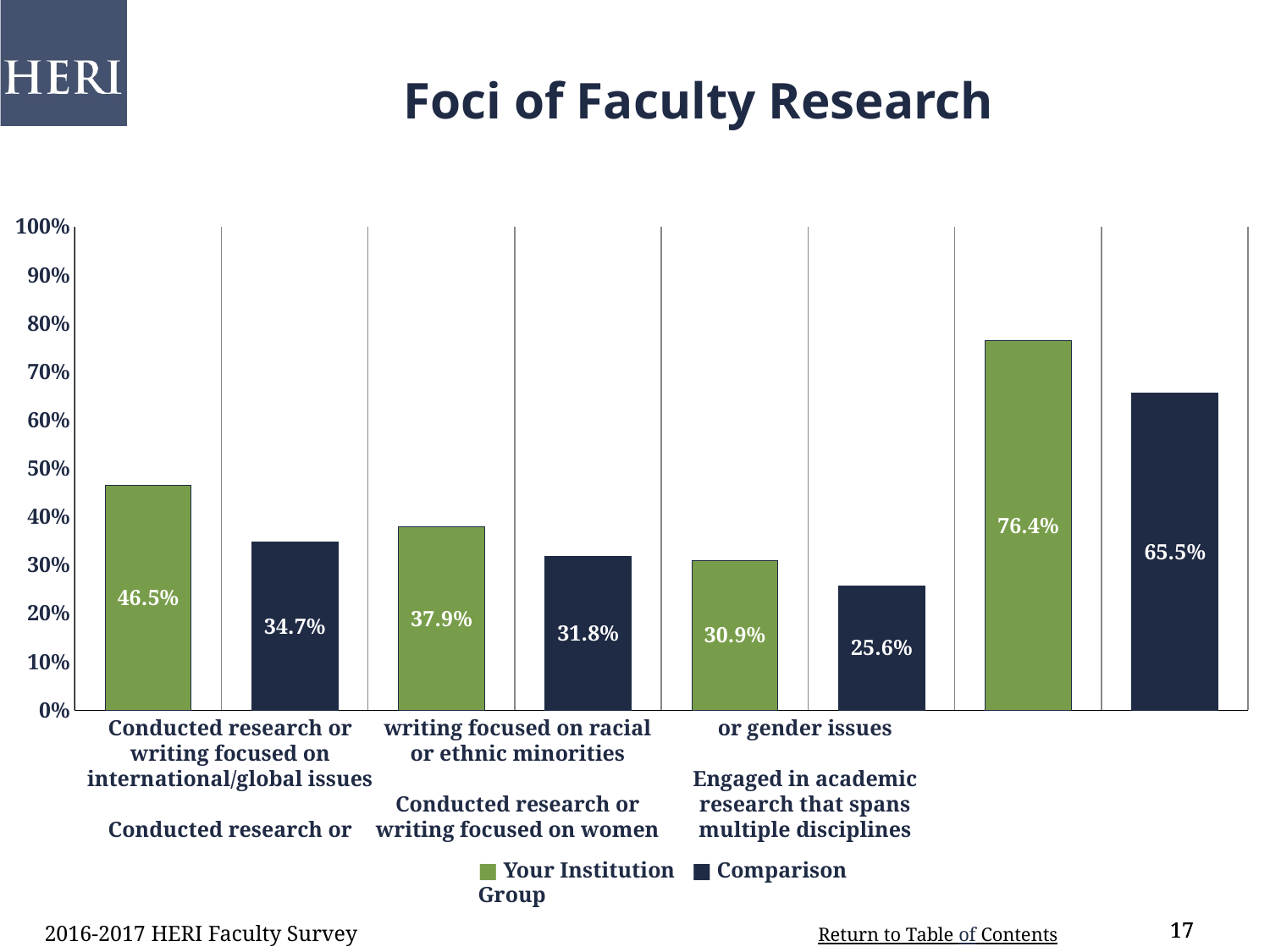
What type of chart is shown on the slide? Bar chart How many series does the legend list? 2 Which category has the lowest Comparison Group value? Conducted research or writing focused on women or gender issues What is the Comparison Group value for research or writing focused on women or gender issues? 25.6% What is the difference between the Your Institution and Comparison Group values for research spanning multiple disciplines? 10.9% What is the Your Institution value for academic research that spans multiple disciplines? 76.4% Which is larger for research or writing focused on international/global issues: Your Institution or Comparison Group? Your Institution Is the Comparison Group value for research spanning multiple disciplines greater or less than 60%? greater What is the Your Institution value for research or writing focused on international/global issues? 46.5% Which category has the highest Your Institution value? Engaged in academic research that spans multiple disciplines What is the Comparison Group value for research or writing focused on racial or ethnic minorities? 31.8% How many categories are shown on the chart? 4